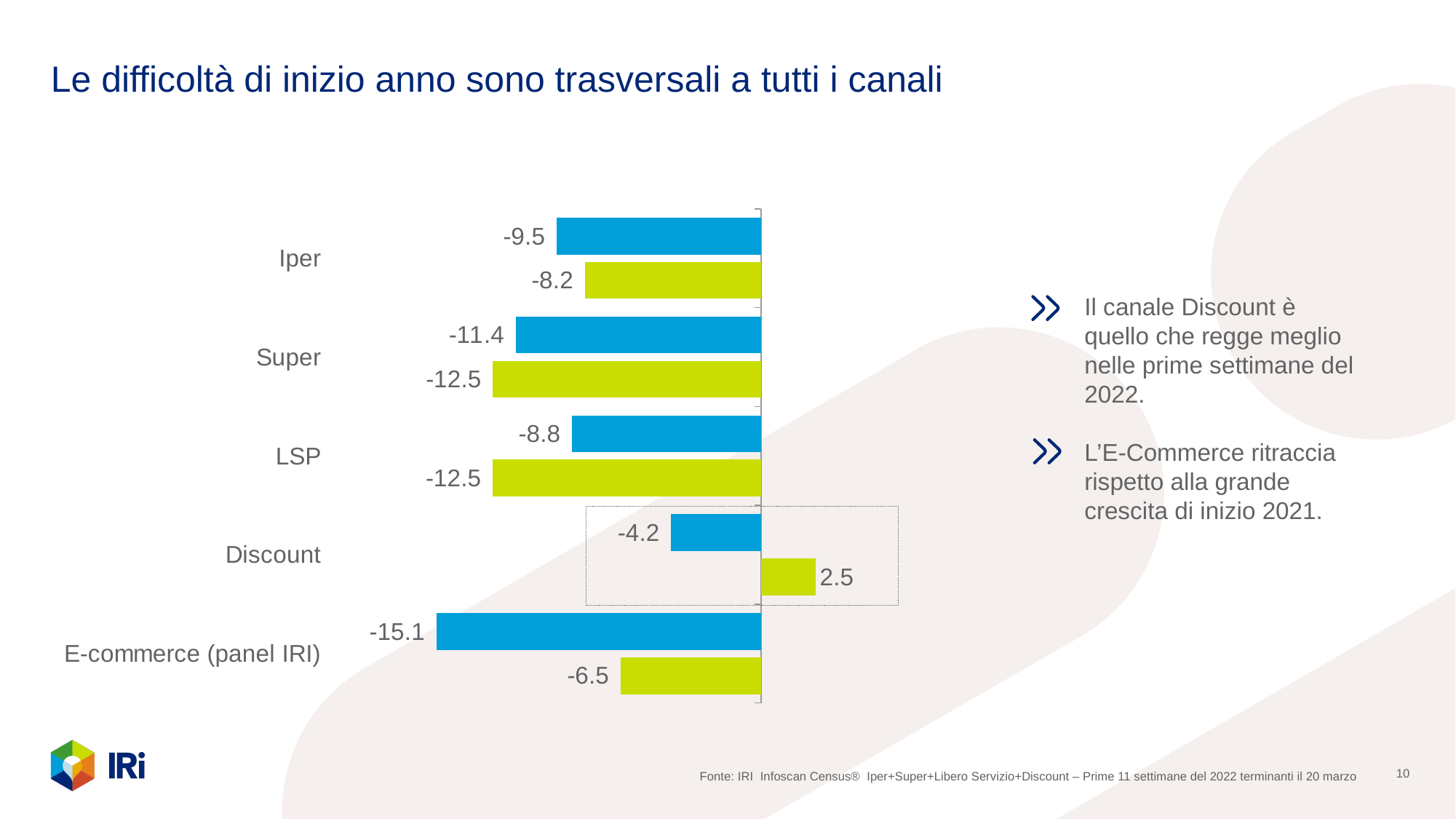
What is the value of the blue bar for Iper? -9.5 What kind of chart is shown on the slide? bar chart Which category has the highest value among the blue bars? Discount Which category has the highest value among the green bars? Discount What is the title of the slide? Le difficoltà di inizio anno sono trasversali a tutti i canali How many categories are shown on the chart? 5 What is the value of the green bar for Super? -12.5 What is the difference between the blue bar and the green bar for E-commerce (panel IRI)? 8.6 What is the value of the blue bar for E-commerce (panel IRI)? -15.1 For LSP, which bar has the larger value, the blue one or the green one? the blue one Which category has the lowest value among the blue bars? E-commerce (panel IRI) What is the value of the green bar for Discount? 2.5